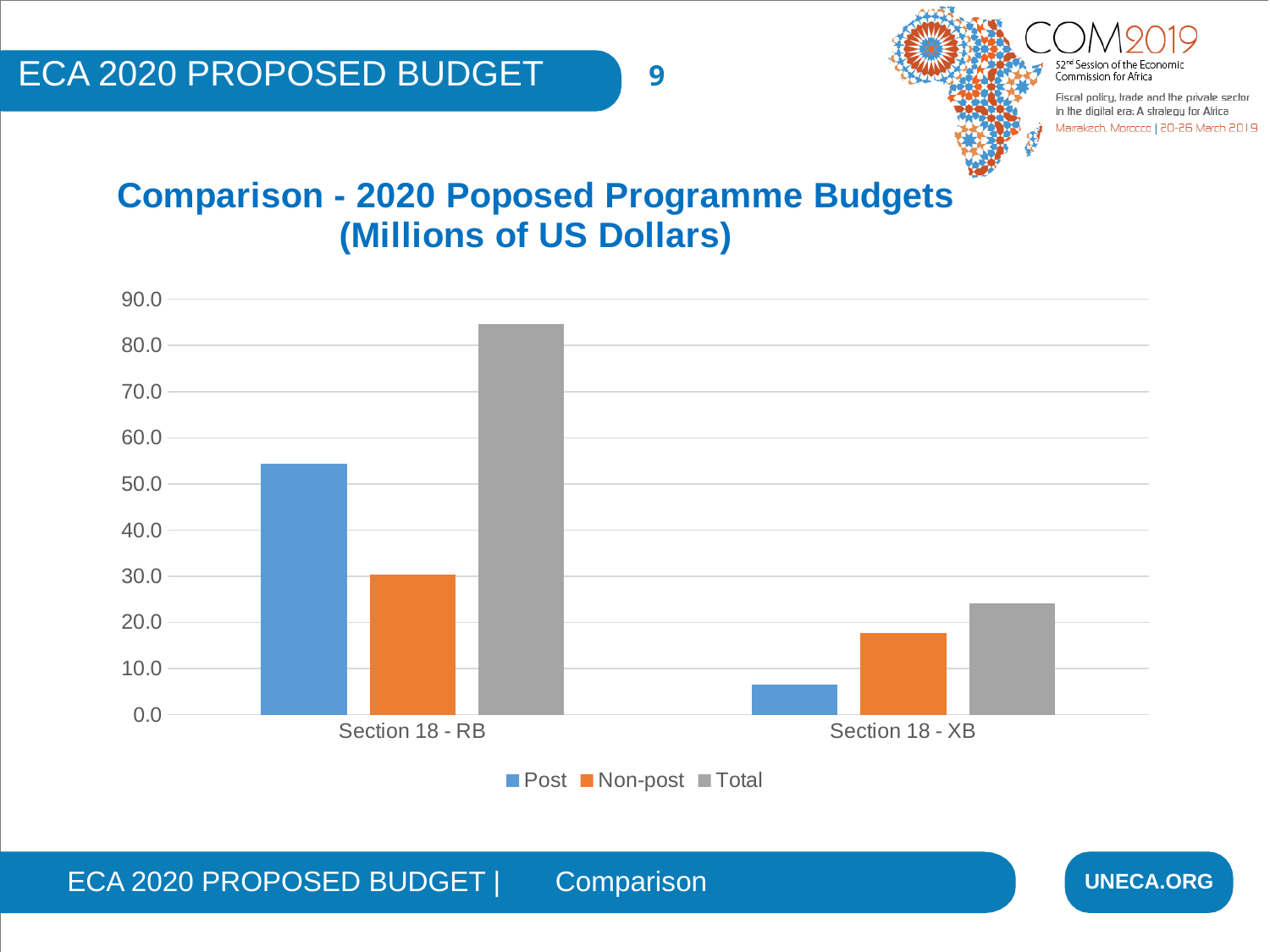
Is the value for Total in Section 18 - RB greater or less than 80.0? greater Is the value for Total in Section 18 - XB greater or less than 20.0? greater Is the value for Post in Section 18 - RB greater or less than 50.0? greater How many categories are shown on the x axis? 2 Which is larger, Post in Section 18 - RB or Non-post in Section 18 - RB? Post in Section 18 - RB What is the title of the chart? Comparison - 2020 Poposed Programme Budgets (Millions of US Dollars) Which series has the lowest value in Section 18 - XB? Post Which series has the highest value in Section 18 - RB? Total How many series does the legend list? 3 What kind of chart is shown on the slide? bar chart